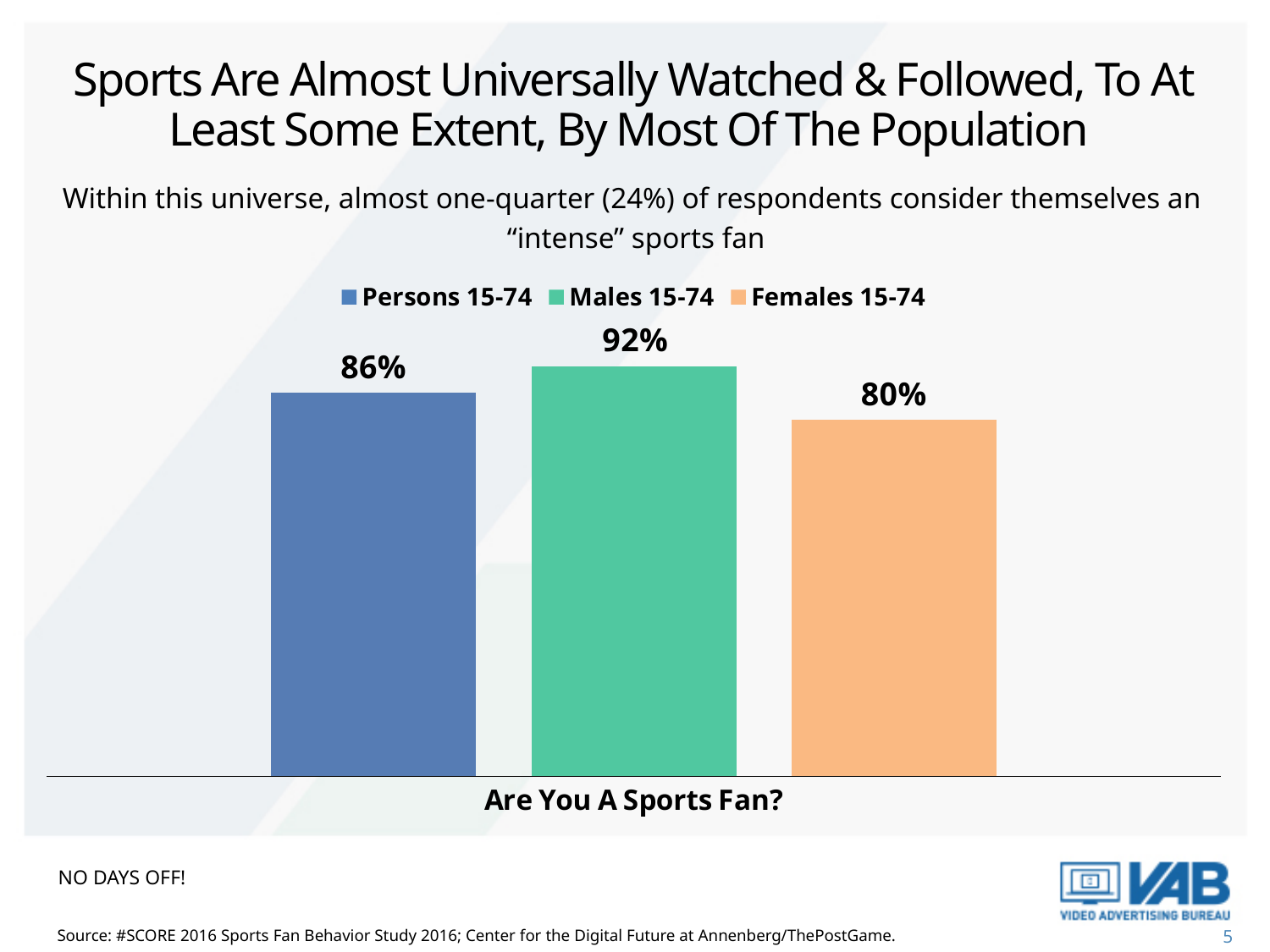
What percentage of Persons 15-74 say they are a sports fan? 86% What is the value for Males 15-74 in the chart? 92% Which group has the highest share of sports fans? Males 15-74 How many bars are shown in the chart? 3 What is the value for Females 15-74 in the chart? 80% Which group has the lowest share of sports fans? Females 15-74 What kind of chart is shown on the slide? Bar chart What is the difference between the values for Males 15-74 and Females 15-74? 12% What is the difference between the values for Males 15-74 and Persons 15-74? 6% What is the label shown beneath the chart's x axis? Are You A Sports Fan? Which is larger, the value for Persons 15-74 or Females 15-74? Persons 15-74 How many series does the legend list? 3